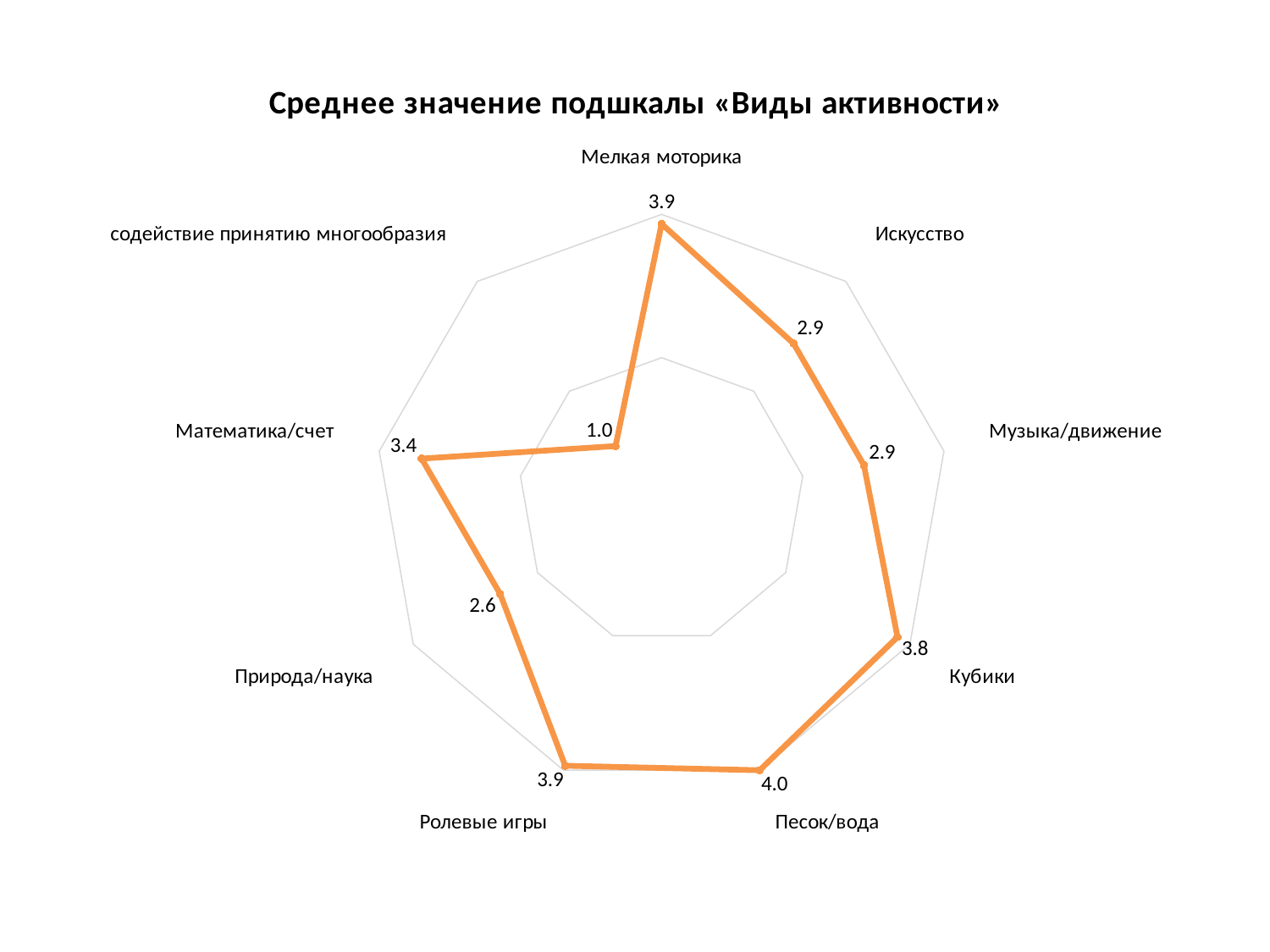
Which category has the highest value? Песок/вода What is the value for Природа/наука? 2.6 Which is larger, the value for Кубики or the value for Искусство? Кубики Which category has the lowest value? содействие принятию многообразия What is the difference between the values for Математика/счет and содействие принятию многообразия? 2.4 What is the value for Кубики? 3.8 What is the difference between the values for Песок/вода and Природа/наука? 1.4 What is the title of the chart? Среднее значение подшкалы «Виды активности» How many categories are plotted on the chart? 9 What is the value for Математика/счет? 3.4 What is the value for Мелкая моторика? 3.9 What kind of chart is shown on the slide? Radar chart